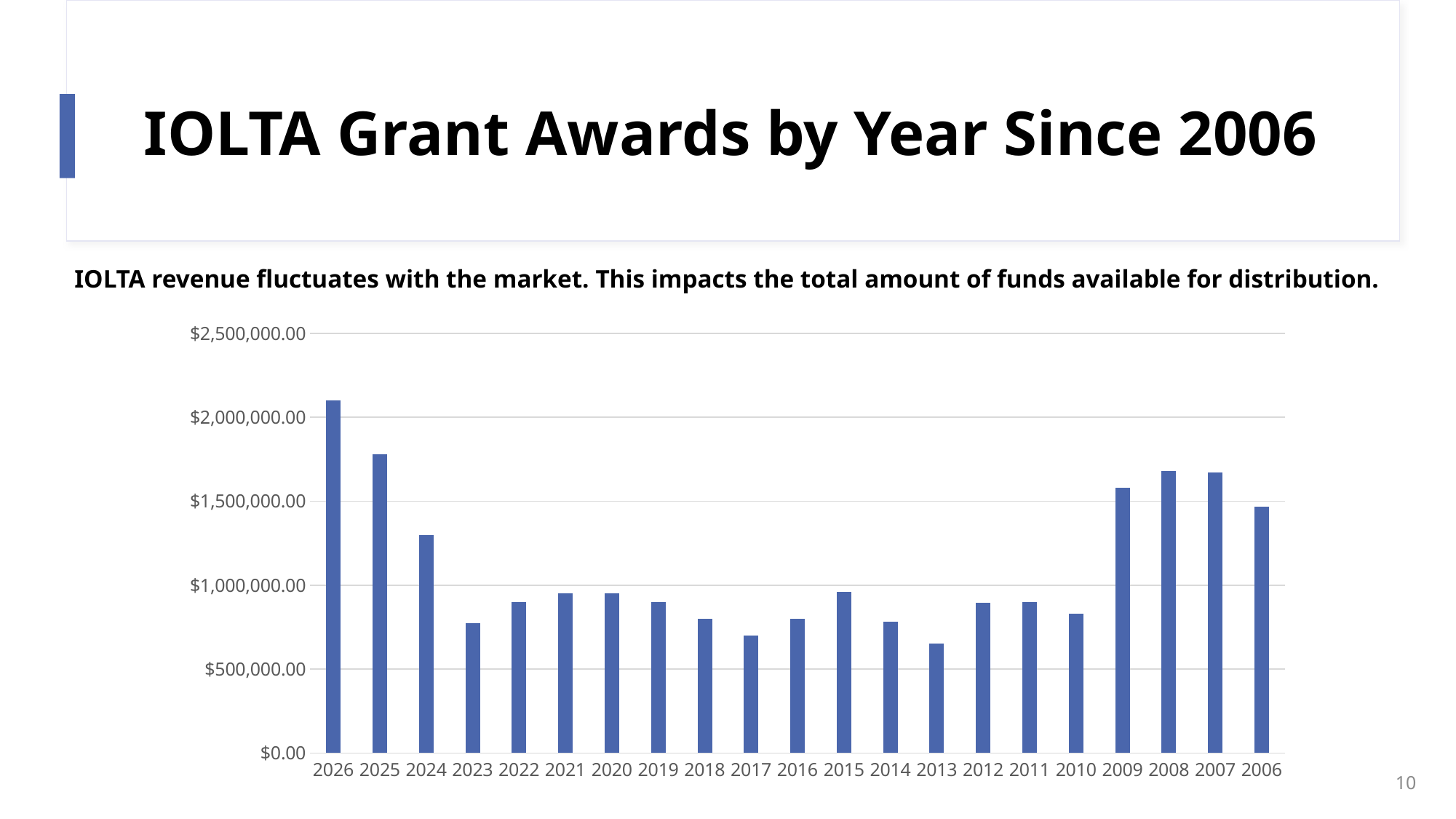
Which year has the larger grant award amount, 2025 or 2024? 2025 Is the value for 2008 greater or less than $1,500,000.00? greater Which year has the lowest grant award amount? 2013 Which year has the larger grant award amount, 2009 or 2006? 2009 Which year has the highest grant award amount? 2026 Is the value for 2024 greater or less than $1,500,000.00? less What kind of chart is shown on the slide? bar chart How many years (bars) are plotted in the chart? 21 Moving from 2026 to 2023 along the x axis, do the values rise or fall? fall Is the value for 2026 greater or less than $2,000,000.00? greater What is the title of the slide's chart? IOLTA Grant Awards by Year Since 2006